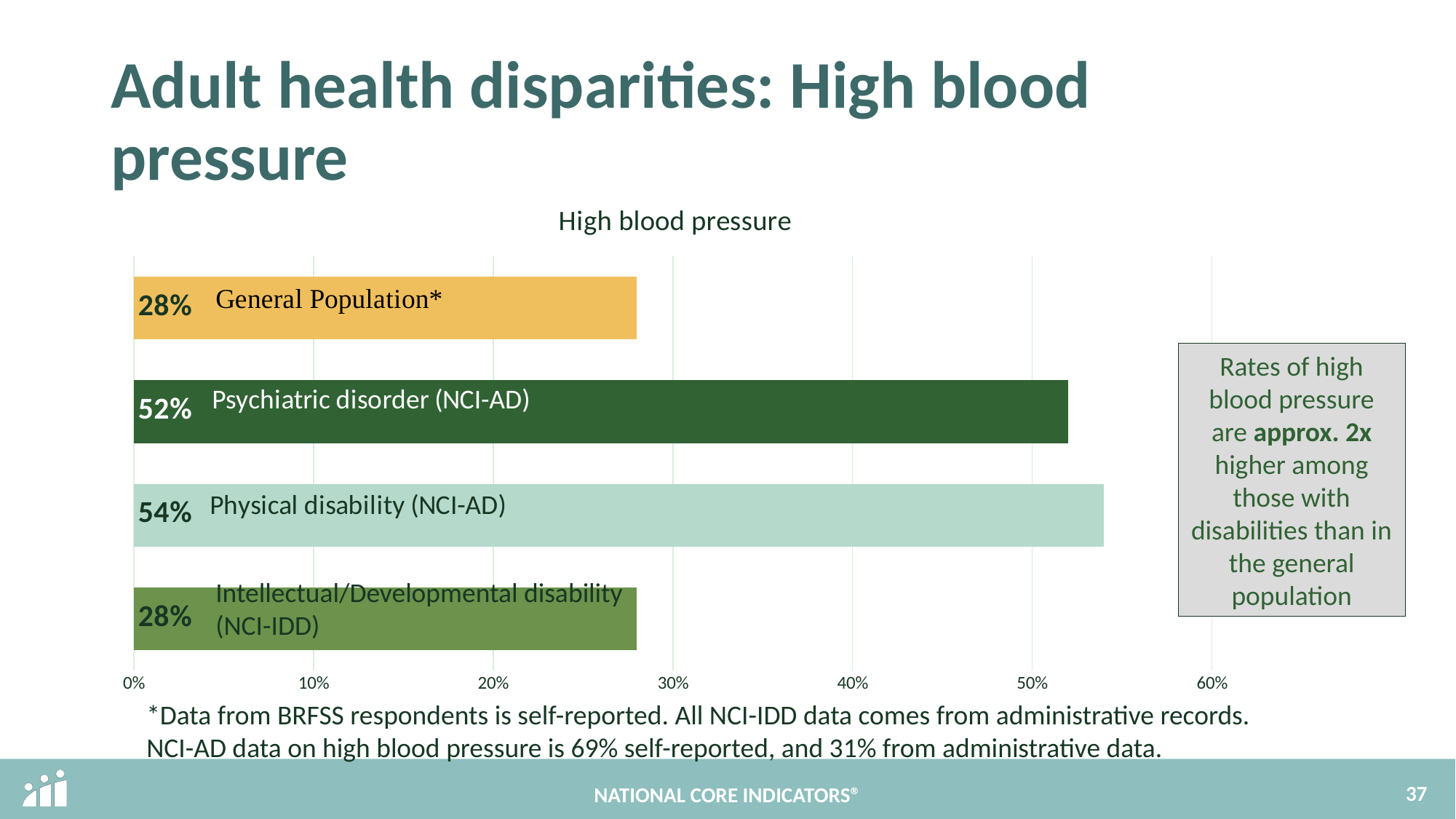
What is the value for Psychiatric disorder (NCI-AD)? 52% How many categories are shown in the chart? 4 What is the difference between the values for Psychiatric disorder (NCI-AD) and Intellectual/Developmental disability (NCI-IDD)? 24% What is the value for Intellectual/Developmental disability (NCI-IDD)? 28% What kind of chart is shown on the slide? bar chart Is the value for Physical disability (NCI-AD) greater or less than 50%? greater Which is larger, the value for Psychiatric disorder (NCI-AD) or the value for General Population*? Psychiatric disorder (NCI-AD) What is the value for Physical disability (NCI-AD)? 54% Which category has the highest value? Physical disability (NCI-AD) What is the title of the chart? High blood pressure What is the value for General Population*? 28% What is the difference between the values for Physical disability (NCI-AD) and General Population*? 26%